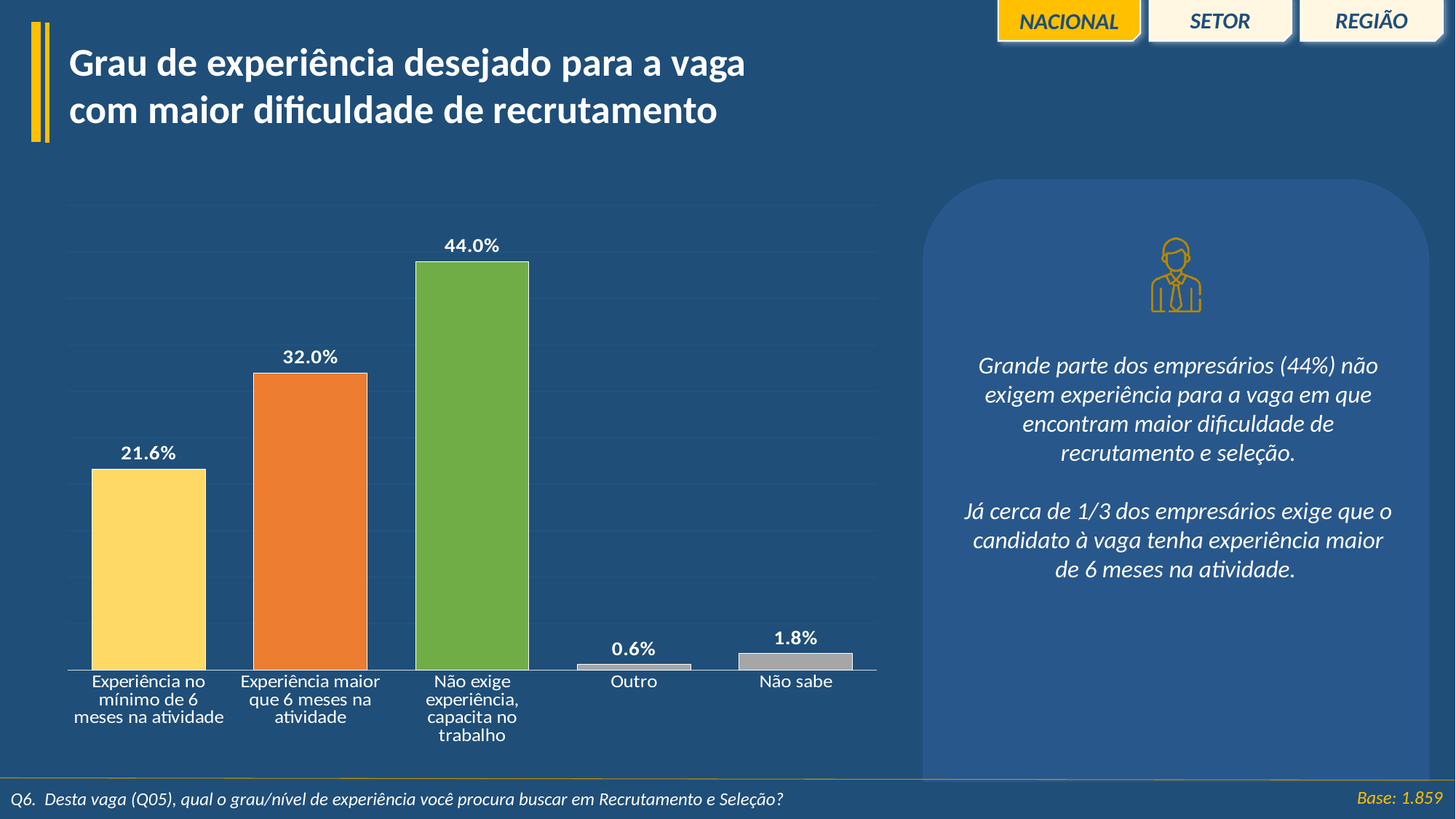
What is the value for "Experiência no mínimo de 6 meses na atividade"? 21.6% How many categories are shown in the chart? 5 Which category has the lowest value? Outro Which category has the highest value? Não exige experiência, capacita no trabalho What kind of chart is shown on the slide? Bar chart What is the value for "Não sabe"? 1.8% What is the difference between the values for "Não exige experiência, capacita no trabalho" and "Experiência maior que 6 meses na atividade"? 12.0% Which is larger: the value for "Experiência no mínimo de 6 meses na atividade" or the value for "Experiência maior que 6 meses na atividade"? Experiência maior que 6 meses na atividade What is the value for "Não exige experiência, capacita no trabalho"? 44.0% What is the title of the slide containing the chart? Grau de experiência desejado para a vaga com maior dificuldade de recrutamento What is the value for "Experiência maior que 6 meses na atividade"? 32.0% What is the value for "Outro"? 0.6%